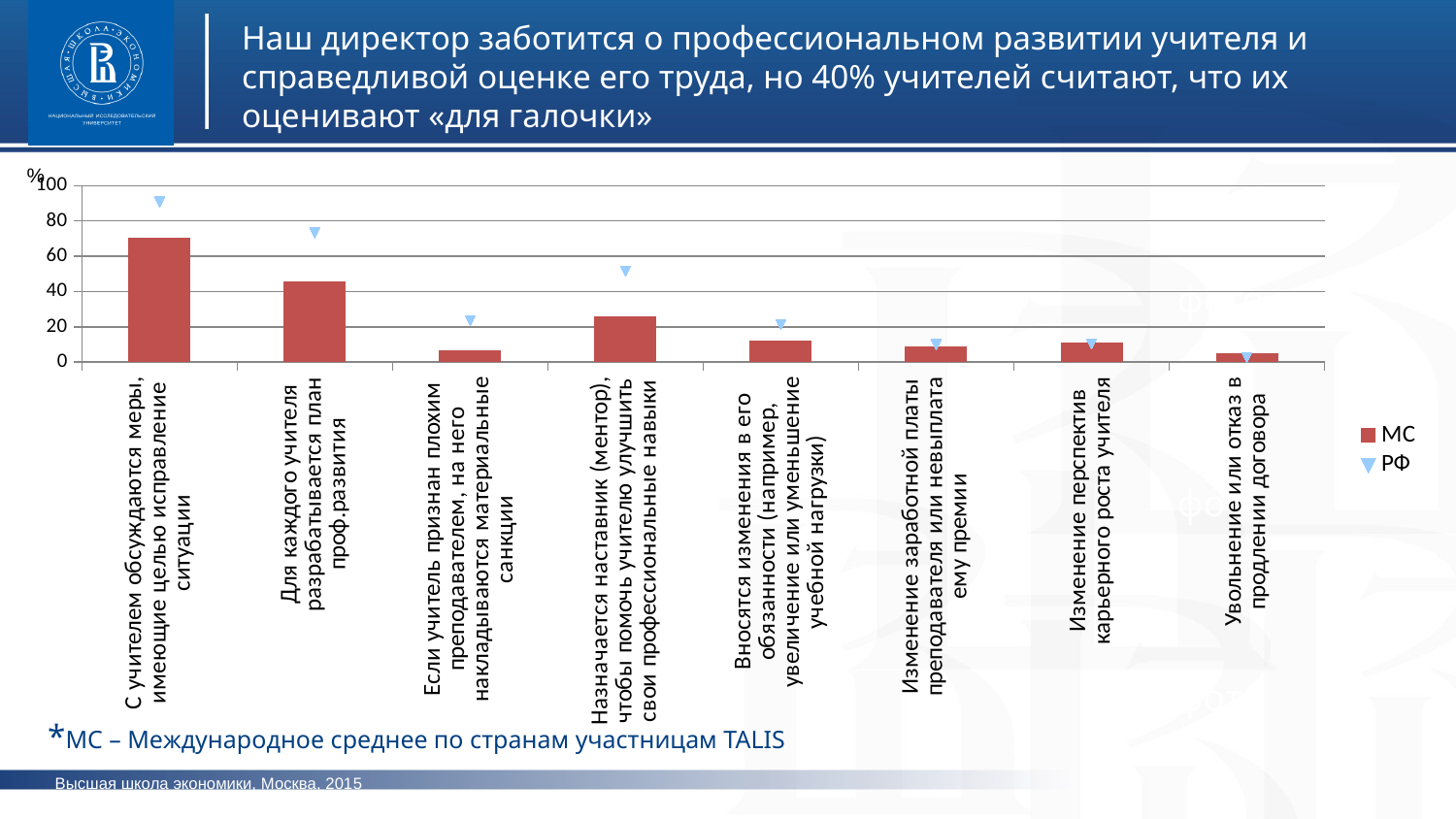
For «Для каждого учителя разрабатывается план проф.развития», which is larger: the MC value or the РФ value? РФ Which category has the highest MC value? С учителем обсуждаются меры, имеющие целью исправление ситуации How many series does the legend list? 2 Is the MC value for «С учителем обсуждаются меры, имеющие целью исправление ситуации» greater or less than 60? greater Which category has the highest РФ value? С учителем обсуждаются меры, имеющие целью исправление ситуации Is the MC value for «Если учитель признан плохим преподавателем, на него накладываются материальные санкции» greater or less than 20? less According to the footnote, what does MC stand for? Международное среднее по странам участницам TALIS Is the РФ value for «Назначается наставник (ментор), чтобы помочь учителю улучшить свои профессиональные навыки» greater or less than 40? greater What kind of chart is shown on the slide? bar chart How many categories are shown along the x axis? 8